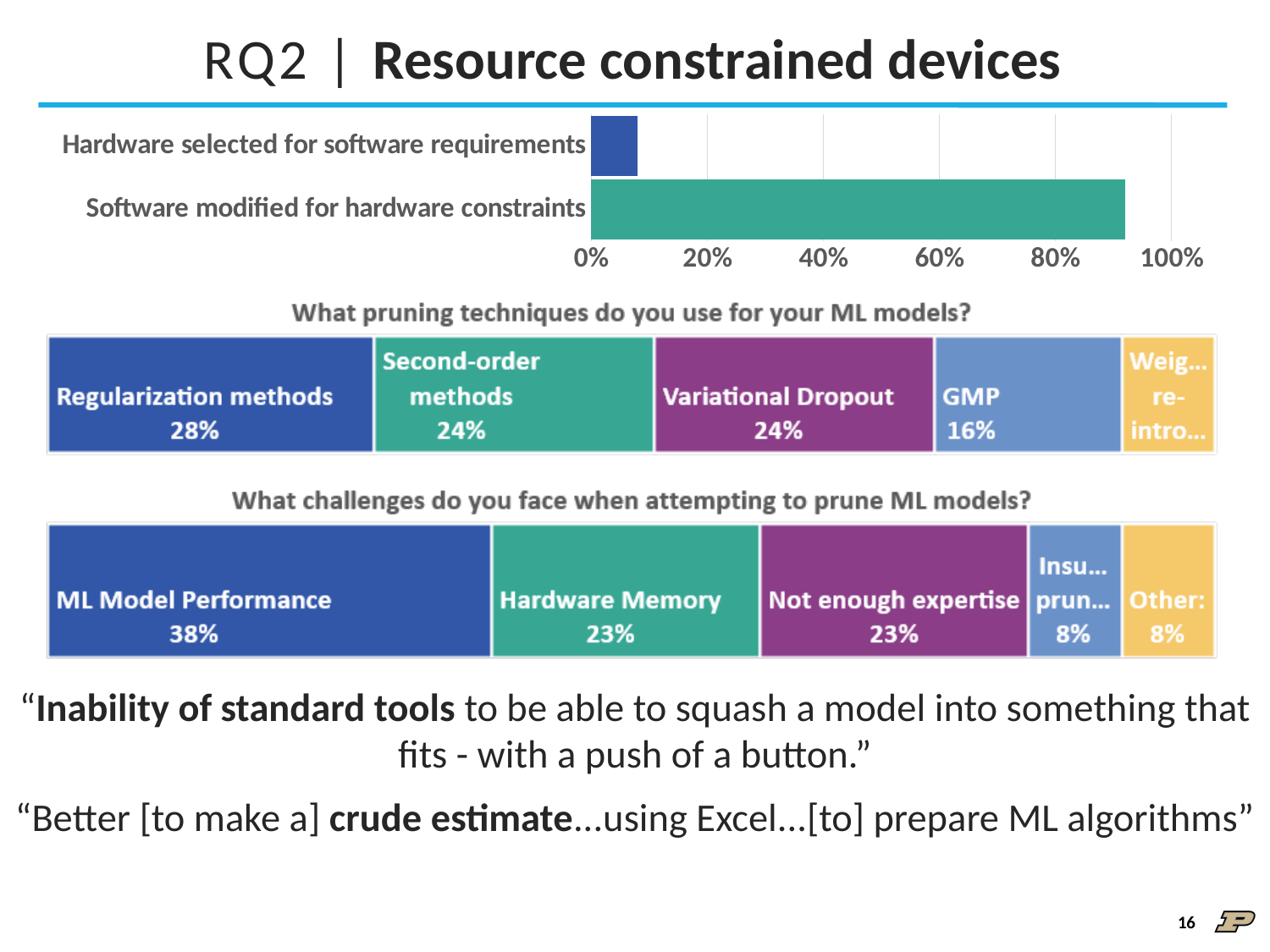
In the top bar chart, is the value for 'Hardware selected for software requirements' greater or less than 20%? less In the chart 'What pruning techniques do you use for your ML models?', what percentage is shown for GMP? 16% In the top bar chart, is the value for 'Software modified for hardware constraints' greater or less than 80%? greater What kind of chart is the top chart on the slide? bar chart In the chart 'What challenges do you face when attempting to prune ML models?', what percentage is shown for Hardware Memory? 23% How many categories are shown in the chart 'What challenges do you face when attempting to prune ML models?'? 5 In the chart 'What pruning techniques do you use for your ML models?', what is the difference between Regularization methods and GMP? 12 percentage points In the top bar chart, which category has the larger value: 'Hardware selected for software requirements' or 'Software modified for hardware constraints'? Software modified for hardware constraints In the chart 'What pruning techniques do you use for your ML models?', what percentage is shown for Regularization methods? 28% In the chart 'What pruning techniques do you use for your ML models?', which technique has the highest percentage? Regularization methods In the chart 'What challenges do you face when attempting to prune ML models?', what is the difference between ML Model Performance and Not enough expertise? 15 percentage points In the chart 'What challenges do you face when attempting to prune ML models?', what percentage is shown for ML Model Performance? 38%